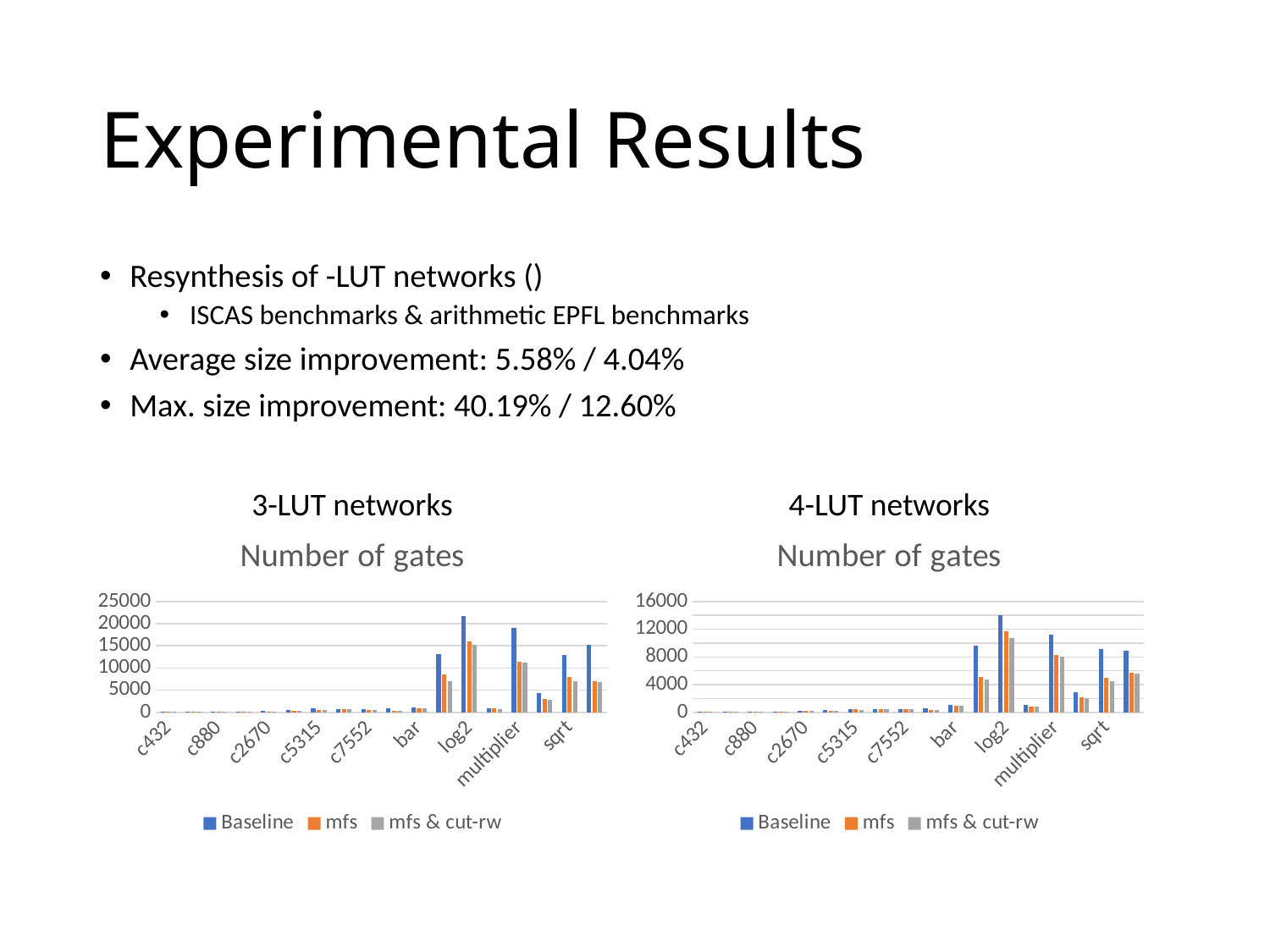
What is the title of the right chart (4-LUT networks)? Number of gates In the right chart (4-LUT networks), is the Baseline value for sqrt greater or less than 12000? less In the left chart (3-LUT networks), is the Baseline value for multiplier greater or less than 15000? greater In the left chart (3-LUT networks), is the Baseline value for log2 greater or less than 20000? greater What are the series names in the legend of the left chart (3-LUT networks)? Baseline, mfs, mfs & cut-rw In the left chart (3-LUT networks), which category has the highest Baseline value? log2 In the right chart (4-LUT networks), which is larger: the Baseline value for log2 or the Baseline value for multiplier? log2 In the left chart (3-LUT networks), which is larger: the Baseline value for log2 or the Baseline value for multiplier? log2 How many series does the legend of the right chart (4-LUT networks) list? 3 What kind of chart is the left chart (3-LUT networks)? bar chart In the right chart (4-LUT networks), which category has the highest Baseline value? log2